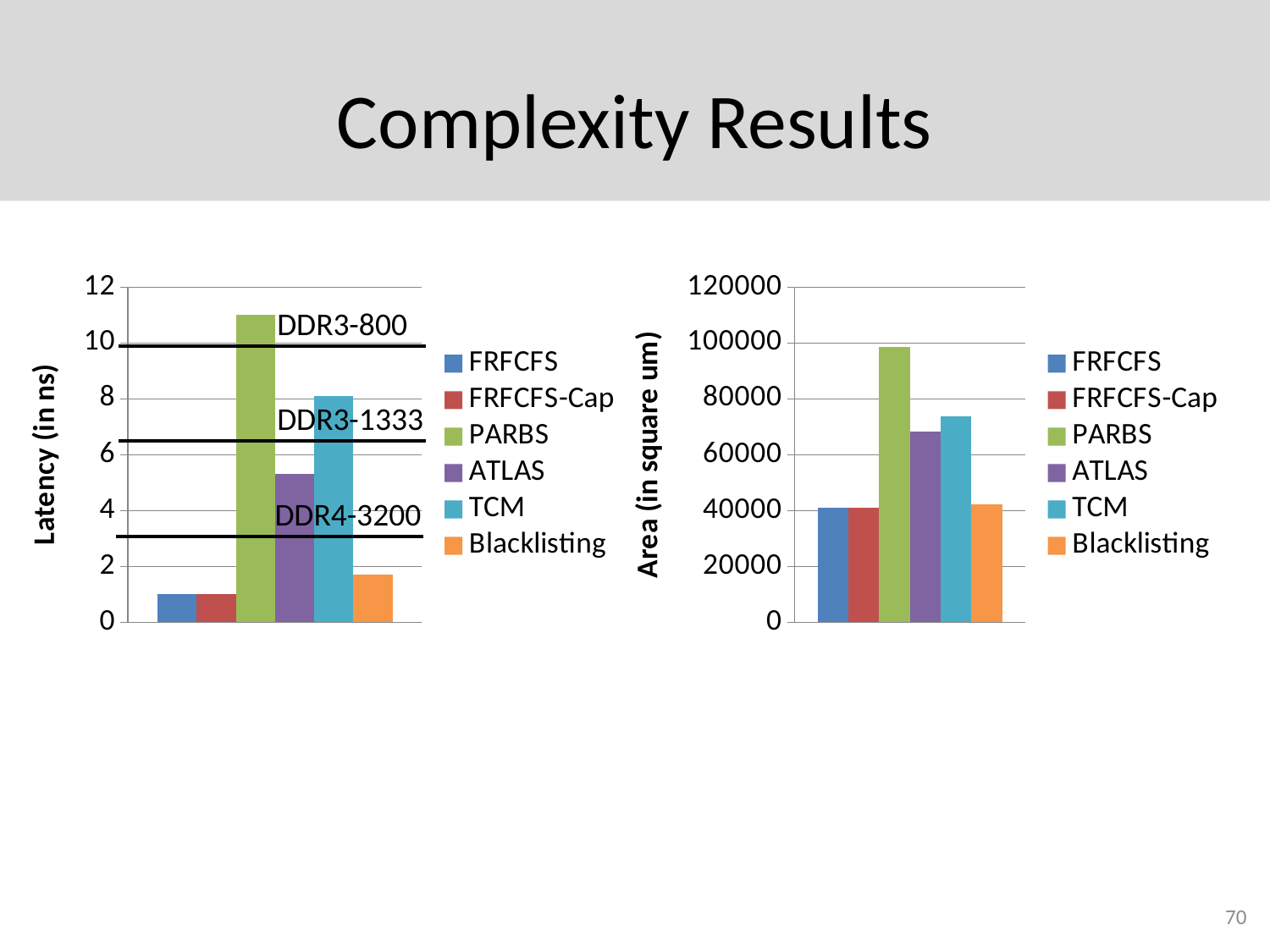
In the left chart (Latency), which series has the highest latency? PARBS In the left chart (Latency), is the value for Blacklisting greater or less than 2? less In the right chart (Area), is the value for ATLAS greater or less than 60000? greater In the right chart (Area), is the value for Blacklisting greater or less than 60000? less What is the y-axis title of the right chart? Area (in square um) In the left chart (Latency), which is larger, the value for ATLAS or the value for Blacklisting? ATLAS In the right chart (Area), which series has the largest area? PARBS In the right chart (Area), which is larger, the value for TCM or the value for ATLAS? TCM How many series does the legend of the right chart (Area) list? 6 What kind of chart is the left chart (Latency)? bar chart